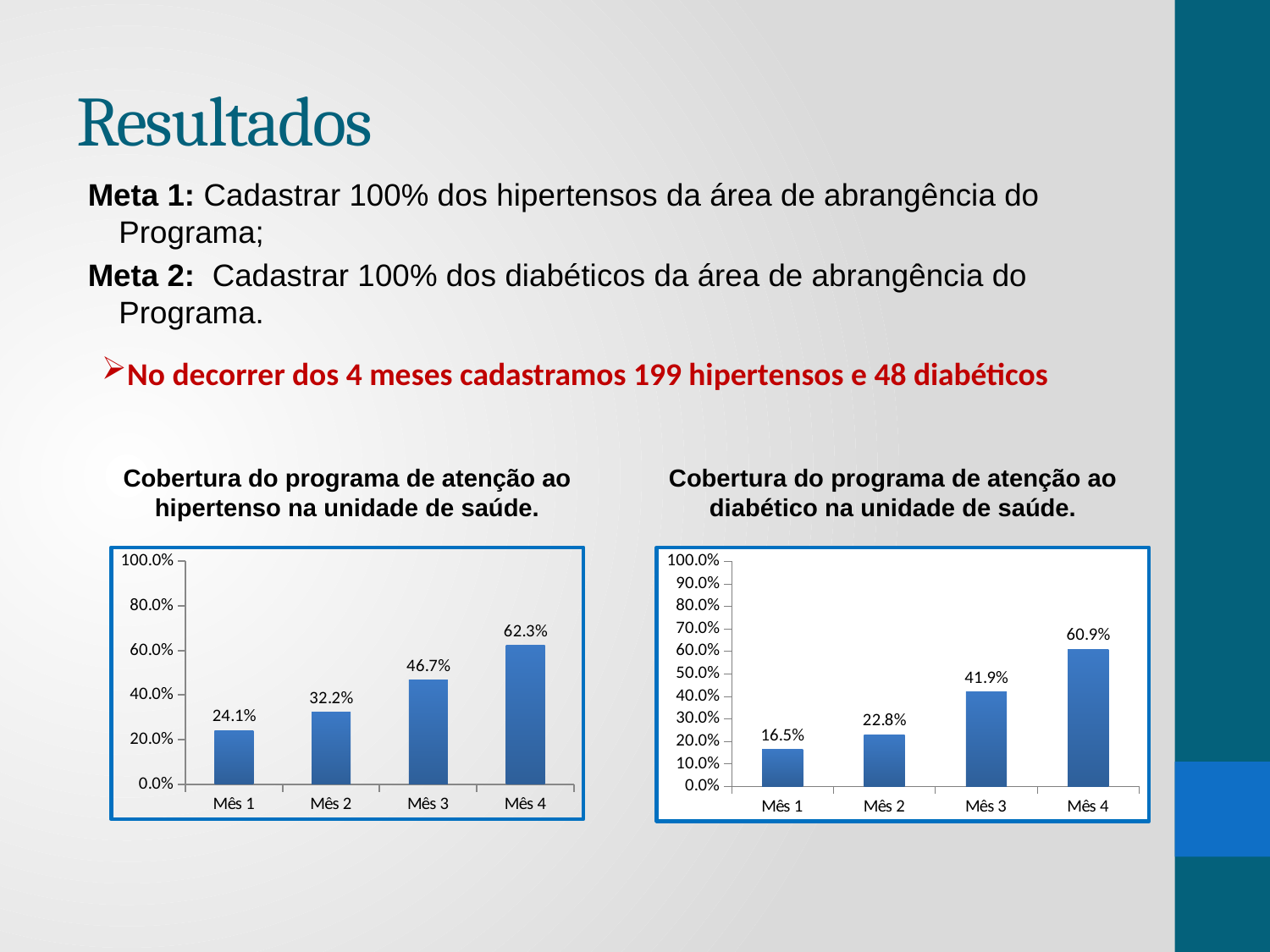
In the right chart (diabético), which is larger: the value for Mês 3 or the value for Mês 4? Mês 4 In the left chart (Cobertura do programa de atenção ao hipertenso), what is the value for Mês 3? 46.7% In the left chart (hipertenso), which month has the highest value? Mês 4 In the left chart (hipertenso), is the value for Mês 2 greater or less than 40.0%? less What kind of chart is the left chart (hipertenso)? Bar chart In the right chart (Cobertura do programa de atenção ao diabético), what is the value for Mês 2? 22.8% How many months (categories) are shown in the right chart (diabético)? 4 In the left chart (hipertenso), what is the difference between the values for Mês 4 and Mês 1? 38.2% In the right chart (diabético), do the values rise or fall from Mês 1 to Mês 4? Rise What is the title of the chart on the right side of the slide? Cobertura do programa de atenção ao diabético na unidade de saúde. In the right chart (diabético), what is the difference between the values for Mês 3 and Mês 2? 19.1% In the right chart (diabético), which month has the lowest value? Mês 1